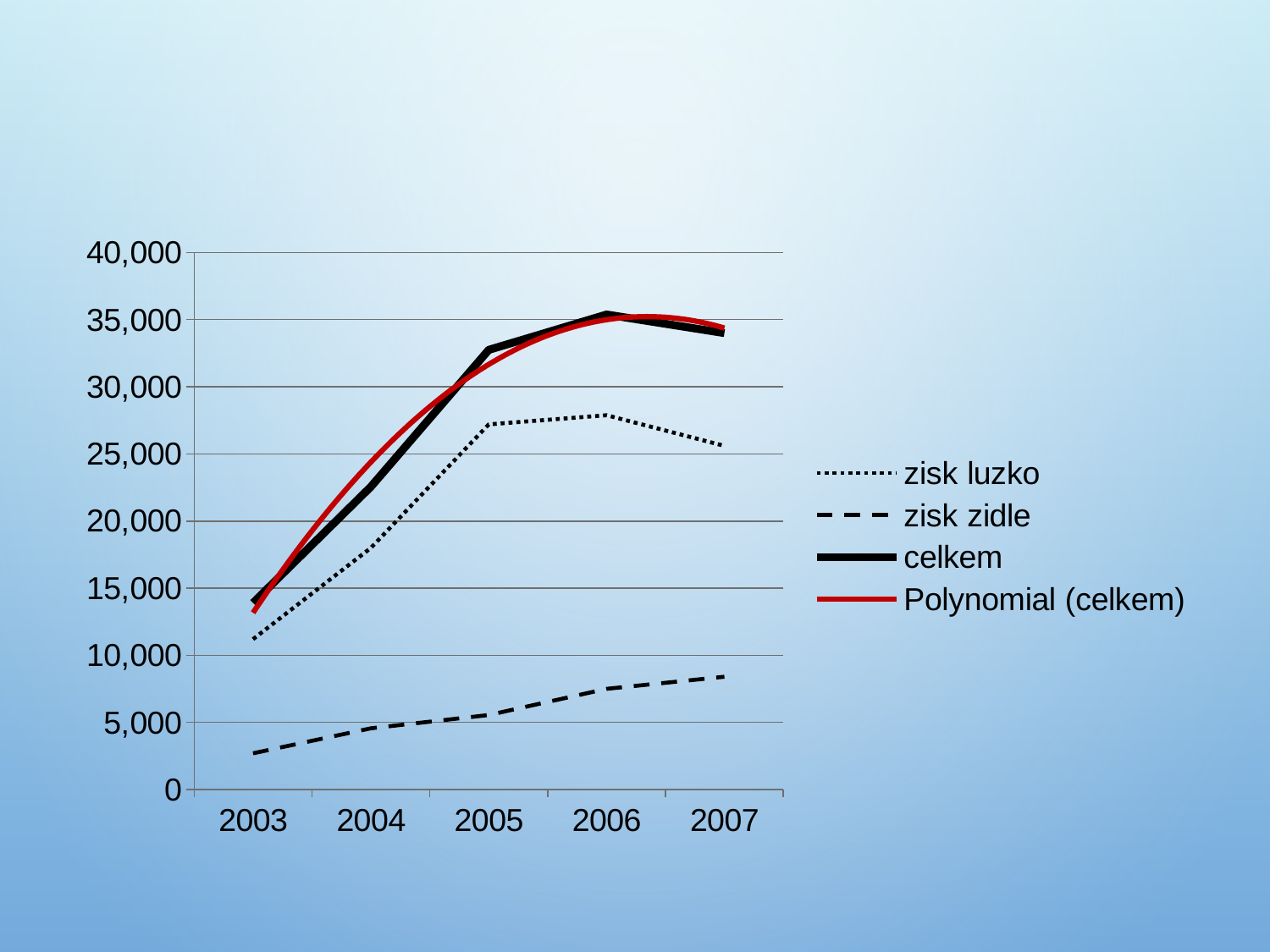
In which year is the zisk zidle series at its lowest? 2003 How many series does the legend list? 4 In 2006, which is larger: zisk luzko or zisk zidle? zisk luzko What kind of chart is shown on the slide? line chart In which year does the celkem series reach its highest value? 2006 How many years are shown on the x axis? 5 Does the zisk zidle series rise or fall from 2003 to 2007? rise In which year is the celkem series at its lowest? 2003 What colour is the Polynomial (celkem) line? red Is the value of zisk zidle in 2007 greater or less than 10,000? less Is the value of celkem in 2005 greater or less than 30,000? greater Is the value of zisk luzko in 2003 greater or less than 15,000? less